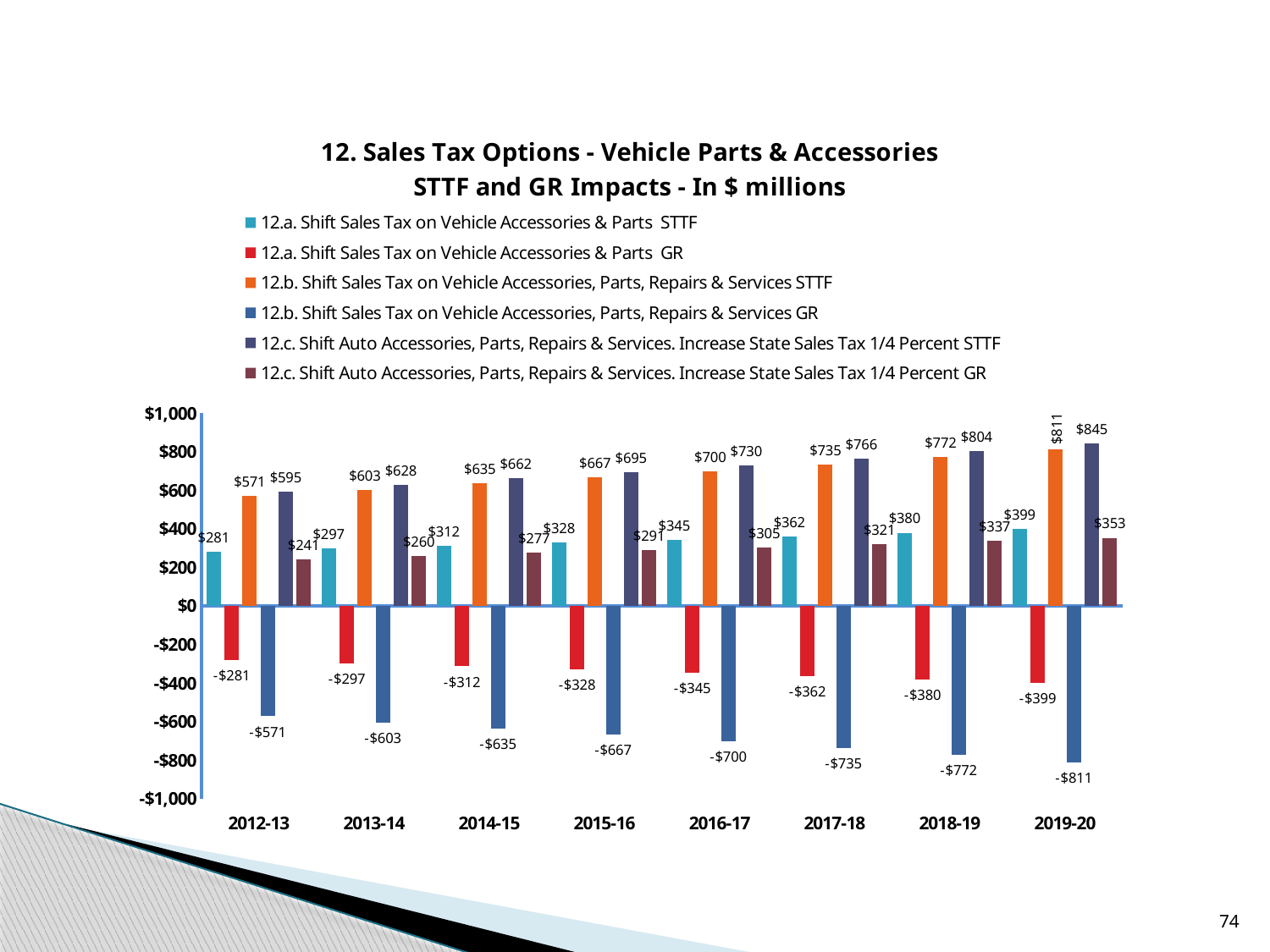
Does the 12.a STTF series rise or fall from 2012-13 to 2019-20? Rise What is the difference between the 12.c STTF value and the 12.b STTF value in 2018-19? $32 In which year is the 12.b GR series (Shift Sales Tax on Vehicle Accessories, Parts, Repairs & Services GR) lowest? 2019-20 How many series does the legend list? 6 What is the value of the 12.b STTF series (Shift Sales Tax on Vehicle Accessories, Parts, Repairs & Services STTF) for 2016-17? $700 What kind of chart is shown on the slide? Bar chart Which is larger in 2014-15: the 12.a STTF value or the 12.c GR value? 12.a STTF ($312) What is the value of the 12.c GR series (Increase State Sales Tax 1/4 Percent GR) for 2012-13? $241 In which year is the 12.c STTF series highest? 2019-20 What is the value of the 12.a GR series (Shift Sales Tax on Vehicle Accessories & Parts GR) for 2015-16? -$328 What is the value of the 12.c STTF series (Shift Auto Accessories, Parts, Repairs & Services, Increase State Sales Tax 1/4 Percent STTF) for 2019-20? $845 How many fiscal years are shown on the x axis? 8